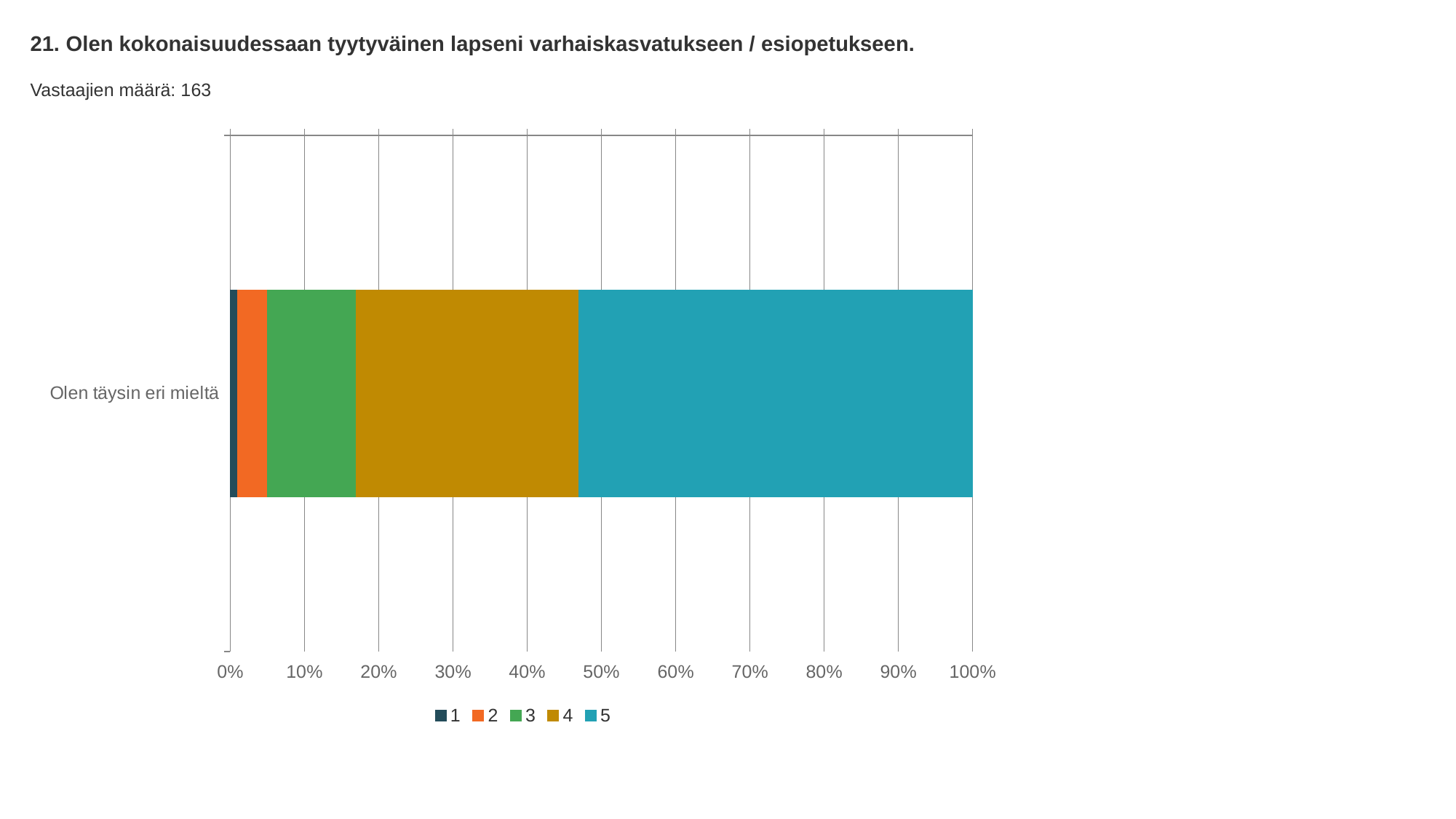
What kind of chart is shown on the slide? bar chart Which segment is larger, series 2 or series 3? 3 Is the share for series 2 greater or less than 10%? less Which series has the largest segment in the stacked bar? 5 How many categories are plotted on the y axis? 1 Is the share for series 5 greater or less than 50%? greater Which segment is larger, series 4 or series 3? 4 At what value on the x axis does the full stacked bar end? 100% What is the label of the category shown on the y axis? Olen täysin eri mieltä Which series has the smallest segment in the stacked bar? 1 How many series does the legend list? 5 Is the share for series 4 greater or less than 20%? greater